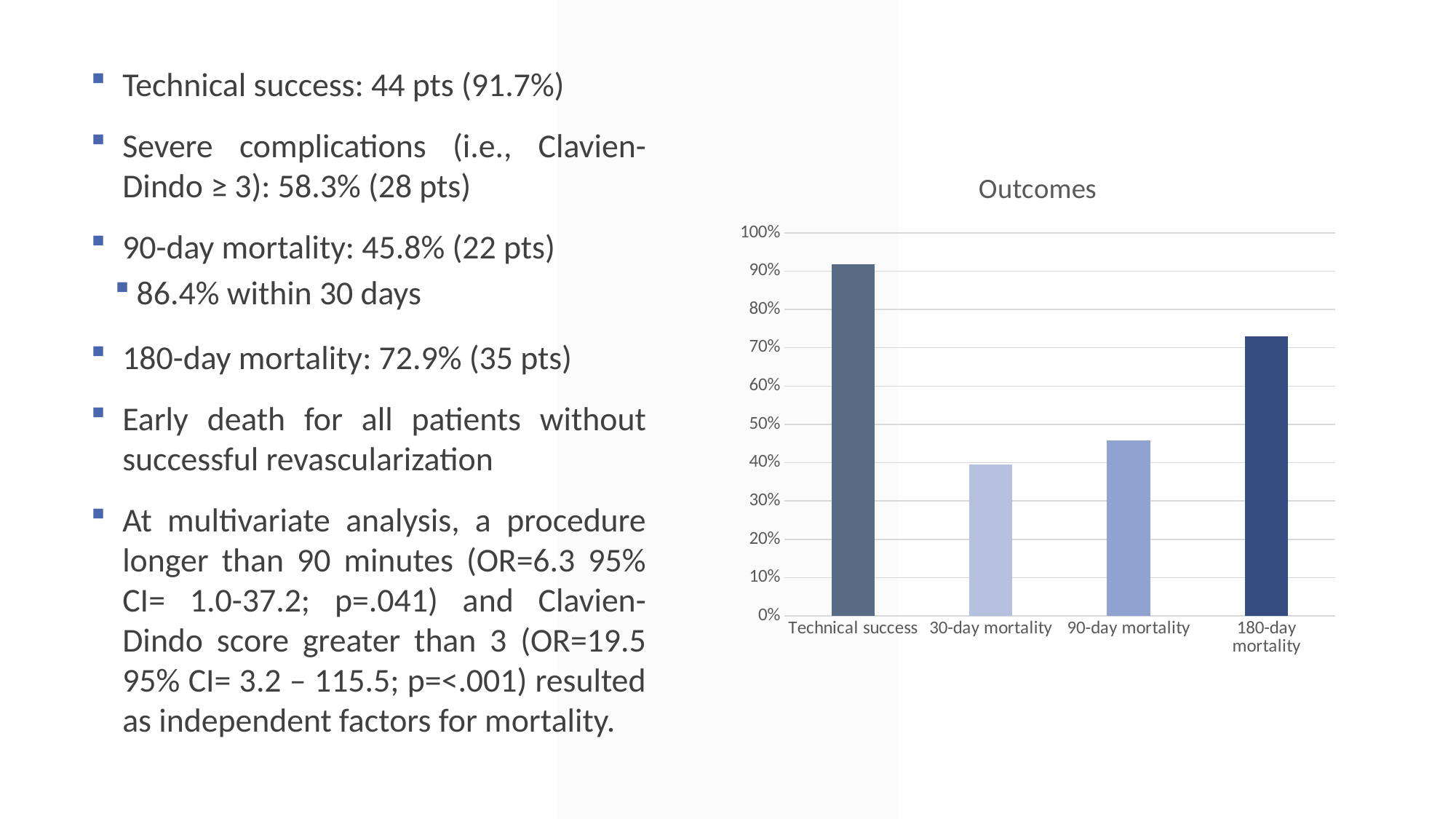
What kind of chart is shown on the slide? bar chart Do the mortality bars rise or fall from 30-day mortality to 180-day mortality? rise Is the value for Technical success greater or less than 90%? greater Is the value for 180-day mortality greater or less than 80%? less What is the title of the chart? Outcomes Which is larger, the value for 90-day mortality or the value for 30-day mortality? 90-day mortality Is the value for 90-day mortality greater or less than 40%? greater Which category has the highest bar in the chart? Technical success Which is larger, the value for 180-day mortality or the value for 90-day mortality? 180-day mortality Which category has the lowest bar in the chart? 30-day mortality How many categories are shown on the x axis of the chart? 4